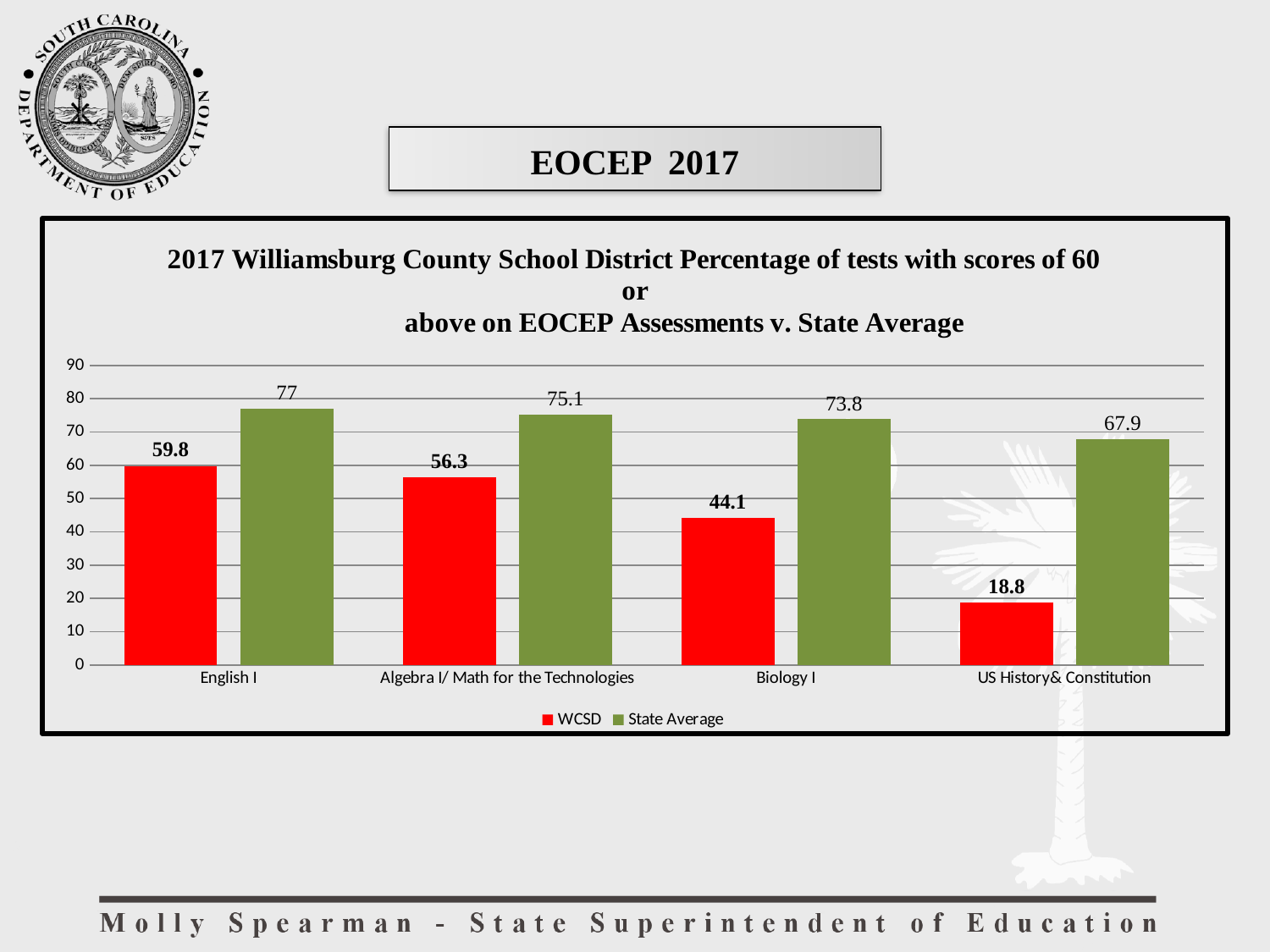
How many categories are shown on the x axis? 4 Which is larger for Algebra I/ Math for the Technologies, the WCSD value or the State Average value? State Average What is the difference between the State Average and WCSD values for Biology I? 29.7 Which category has the lowest WCSD value? US History& Constitution Which category has the highest State Average value? English I What is the State Average value for Biology I? 73.8 What is the WCSD value for US History& Constitution? 18.8 How many series does the legend list? 2 What is the difference between the State Average and WCSD values for US History& Constitution? 49.1 What is the State Average value for Algebra I/ Math for the Technologies? 75.1 What is the WCSD value for English I? 59.8 What kind of chart is shown on the slide? Bar chart